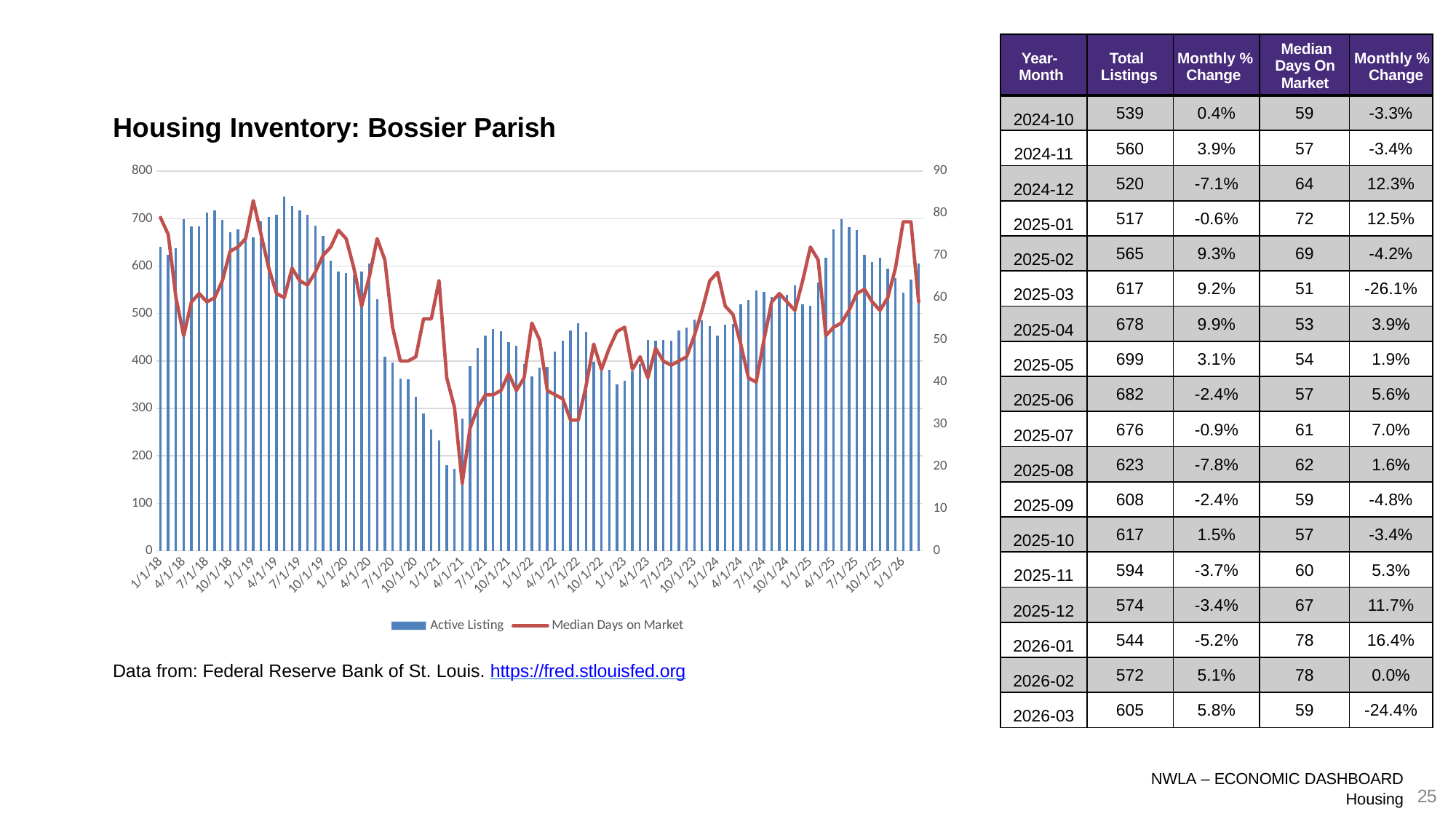
According to the table on the slide, which Year-Month has the lowest Median Days On Market? 2025-03 How many series does the legend of the Housing Inventory chart list? 2 What is the maximum value shown on the left vertical axis of the Housing Inventory chart? 800 In the Housing Inventory chart, is the Active Listing value at 1/1/18 greater or less than 600? greater Which series in the Housing Inventory chart is drawn as a red line? Median Days on Market In the Housing Inventory chart, is the Active Listing value at 4/1/21 greater or less than 200? greater In the Housing Inventory chart, is the Median Days on Market value at 4/1/21 greater or less than 20? less What kind of chart is shown under the title 'Housing Inventory: Bossier Parish'? A combined bar and line chart According to the table on the slide, what is the difference in Total Listings between 2026-03 and 2026-02? 33 According to the table on the slide, what was the Total Listings value for 2025-05? 699 According to the table on the slide, what was the Median Days On Market for 2026-01? 78